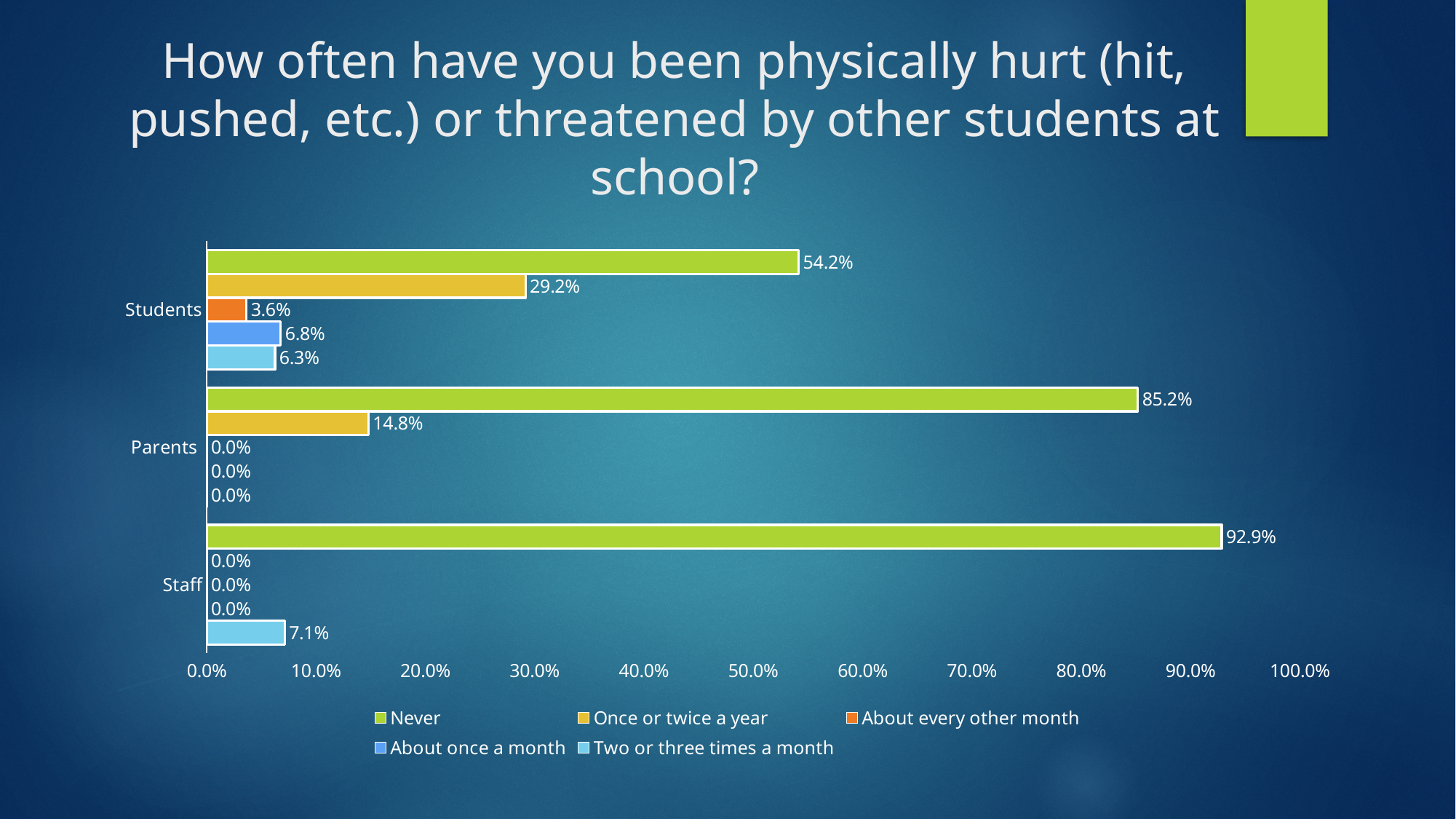
Which group has the highest percentage for "Never"? Staff What is the difference between the "Never" percentages for Staff and Students? 38.7% What percentage of Staff answered "Two or three times a month"? 7.1% What kind of chart is shown on the slide? Bar chart What percentage of Students answered "Never"? 54.2% How many series does the legend list? 5 What percentage of Parents answered "Once or twice a year"? 14.8% Which is larger for Students: "About once a month" or "Two or three times a month"? About once a month How many groups are shown on the vertical axis? 3 Which group has the lowest percentage for "Never"? Students Is the "Never" value for Parents greater or less than 80.0%? greater What percentage of Students answered "About every other month"? 3.6%